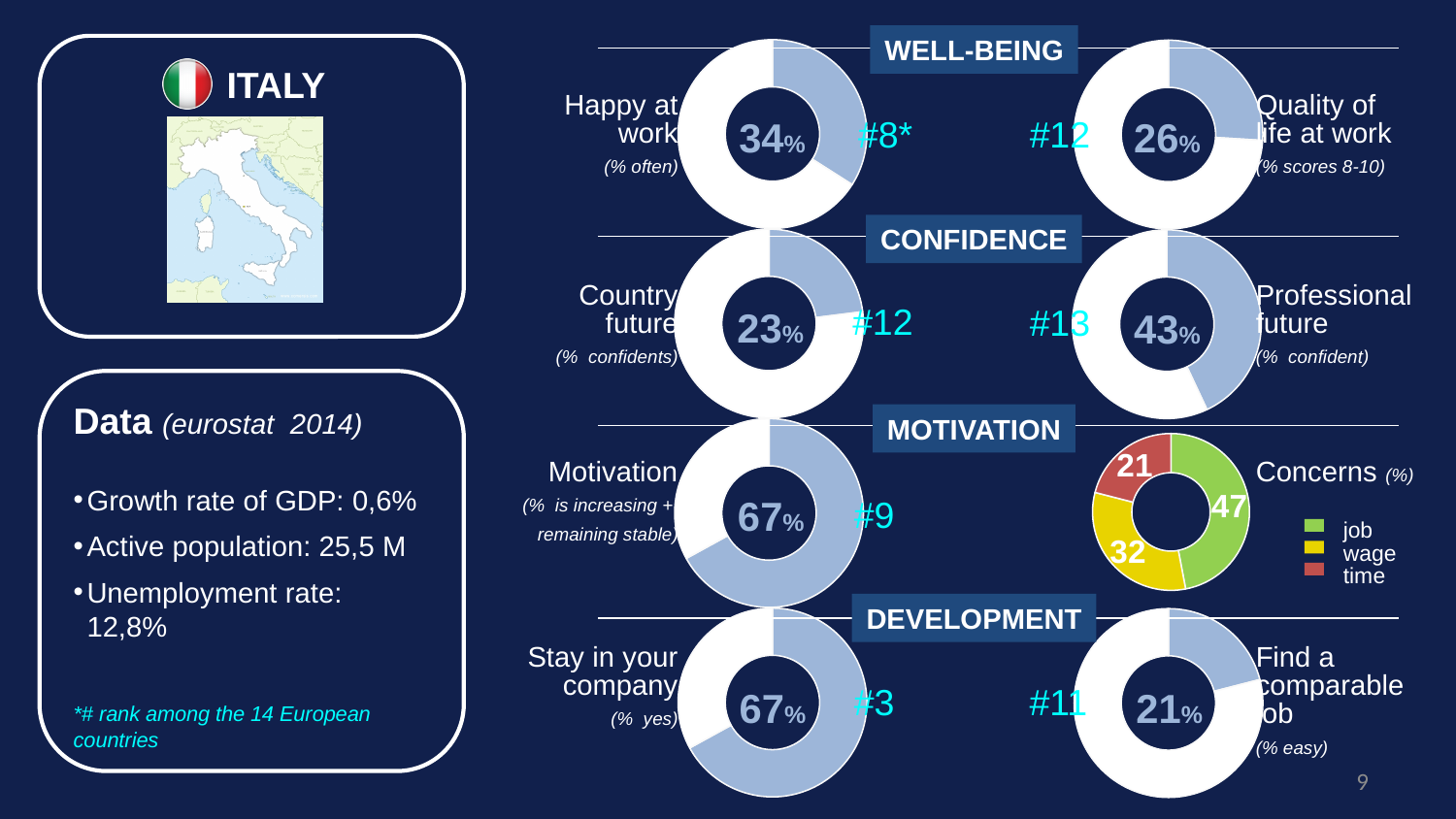
On the 'Quality of life at work' donut chart, what value is printed in the centre? 26% Which is larger: the value on the 'Professional future' chart or the value on the 'Country future' chart? Professional future On the 'Professional future' donut chart, what value is shown? 43% On the 'Concerns' donut chart, what is the difference between the 'job' value and the 'wage' value? 15 What type of chart is used for 'Stay in your company'? Donut (pie) chart On the 'Find a comparable job' donut chart, what percentage is shown? 21% On the 'Concerns' donut chart, what value is shown for the 'job' slice? 47 On the 'Concerns' donut chart, which concern has the smallest slice? time On the 'Concerns' donut chart, which concern has the largest slice? job On the 'Concerns' donut chart, how many categories does the legend list? 3 On the 'Country future' donut chart, what percentage of respondents are confident? 23% On the 'Happy at work' donut chart, what percentage is shown in the centre? 34%